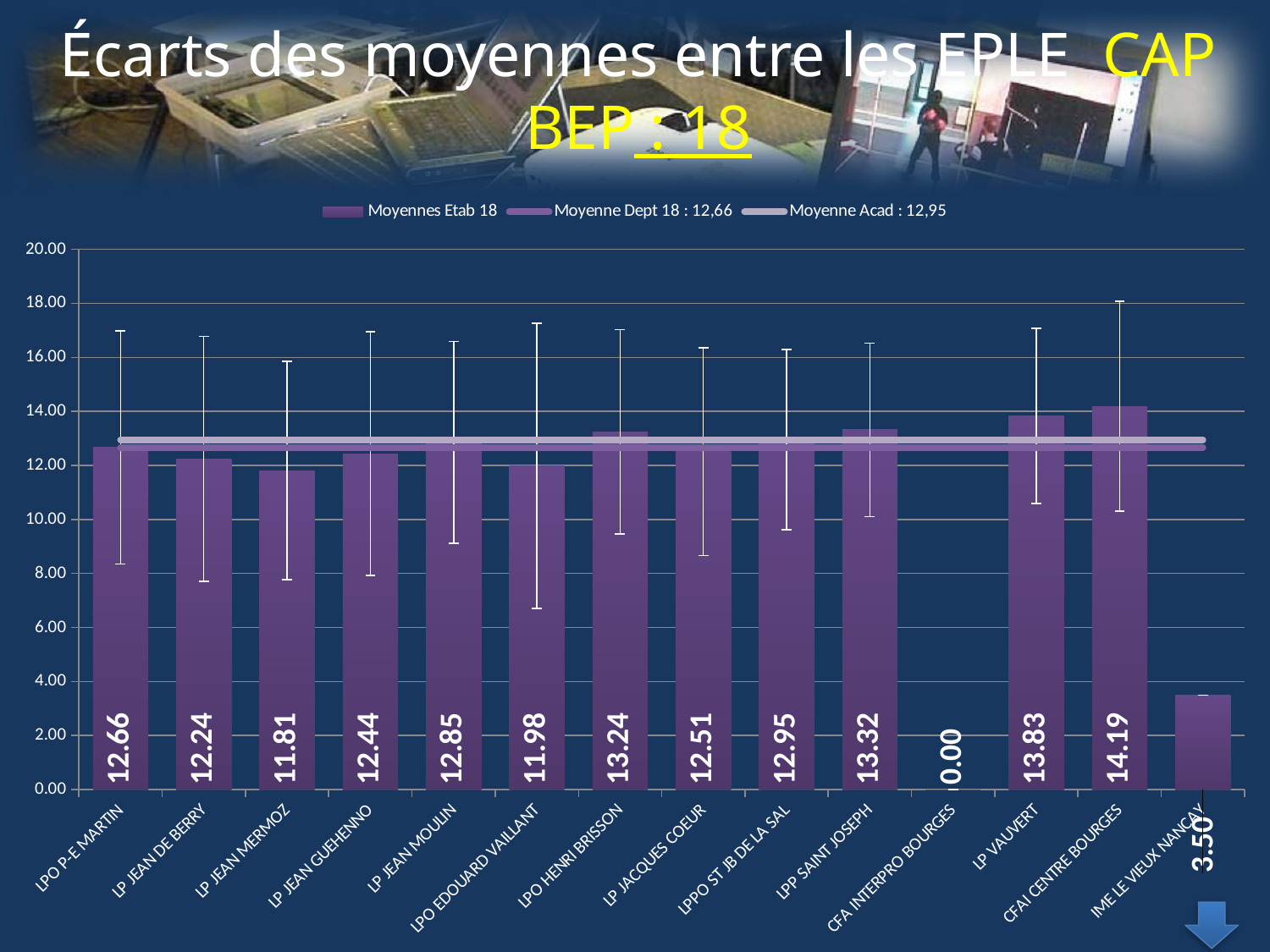
What kind of chart is shown on the slide? combination bar and line chart How many entries does the legend list? 3 What is the value for LPO P-E MARTIN? 12.66 Which establishment has the highest value? CFAI CENTRE BOURGES What is the value for LPP SAINT JOSEPH? 13.32 What is the difference between the values for CFAI CENTRE BOURGES and LP VAUVERT? 0.36 Which establishment has the lowest value? CFA INTERPRO BOURGES How many establishments are shown on the x axis? 14 What is the value for LP VAUVERT? 13.83 What is the value for IME LE VIEUX NANCAY? 3.50 Which is larger, the value for LP VAUVERT or the value for LPP SAINT JOSEPH? LP VAUVERT Is the value for LP JEAN MERMOZ greater or less than 14.00? less